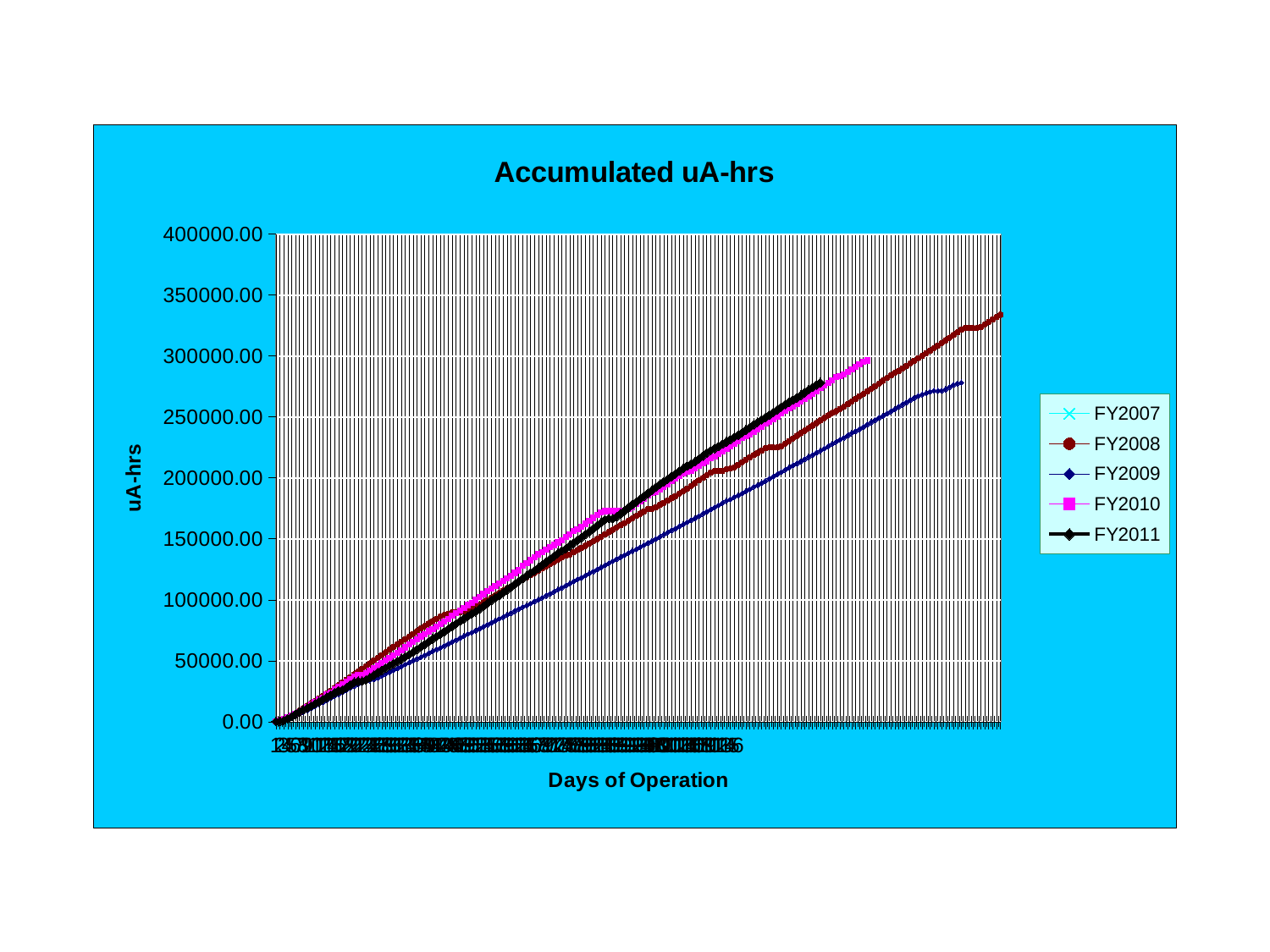
How many series does the legend list? 5 Is the final value of the FY2008 series greater or less than 300000.00? greater Which series extends furthest along the Days of Operation axis? FY2008 Which series ends at a higher accumulated uA-hrs value, FY2008 or FY2009? FY2008 Is the final value of the FY2011 series greater or less than 250000.00? greater What kind of chart is shown on the slide? line chart Is the final value of the FY2009 series greater or less than 300000.00? less What is the title of the chart? Accumulated uA-hrs Do the plotted values rise or fall as the days of operation increase? rise Which series reaches the highest accumulated uA-hrs value on the chart? FY2008 What is the label of the x axis? Days of Operation